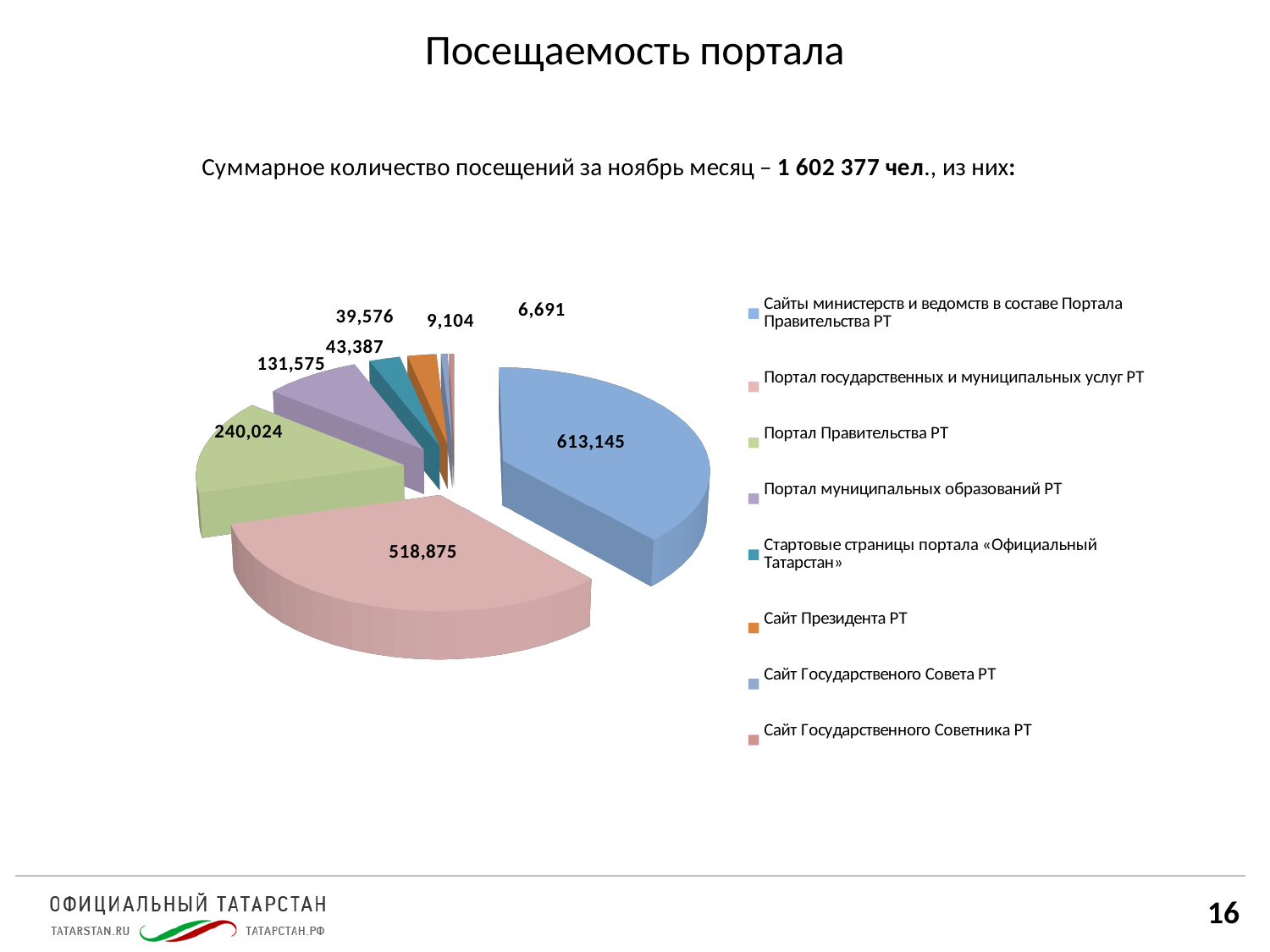
Which category has the smallest slice of the pie? Сайт Государственного Советника РТ What is the value for Сайт Президента РТ? 39,576 What is the difference between the values for Сайты министерств и ведомств в составе Портала Правительства РТ and Портал государственных и муниципальных услуг РТ? 94,270 What is the title of the slide containing the chart? Посещаемость портала How many slices does the pie chart have? 8 What kind of chart is shown on the slide? pie chart What is the value for Портал Правительства РТ? 240,024 Which is larger: the value for Портал муниципальных образований РТ or the value for Стартовые страницы портала «Официальный Татарстан»? Портал муниципальных образований РТ What is the value for Портал государственных и муниципальных услуг РТ? 518,875 How many entries does the legend list? 8 Which category has the largest slice of the pie? Сайты министерств и ведомств в составе Портала Правительства РТ What is the value for Сайты министерств и ведомств в составе Портала Правительства РТ? 613,145